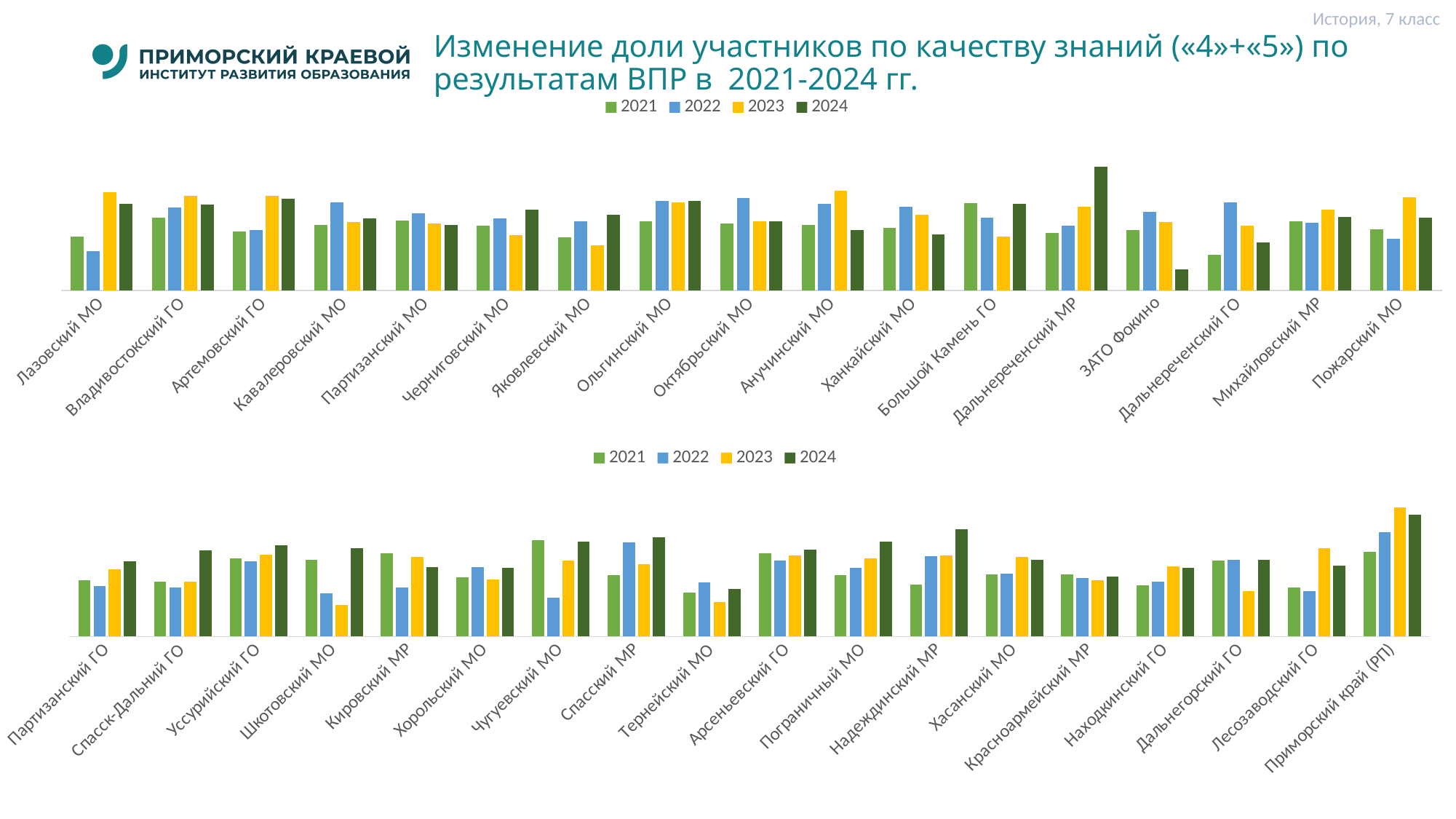
In the top chart, which year has the lowest bar for ЗАТО Фокино? 2024 In the top chart, which year has the highest bar for Дальнереченский МР? 2024 How many categories (municipalities) are shown on the x axis of the top chart? 17 How many categories are shown on the x axis of the bottom chart? 18 In the bottom chart, do the bars for Приморский край (РП) rise or fall from 2021 to 2023? rise In the top chart, for Дальнереченский ГО, is the 2022 bar or the 2023 bar taller? 2022 In the top chart, which year has the lowest bar for Лазовский МО? 2022 In the bottom chart, which year has the lowest bar for Шкотовский МО? 2023 What kind of chart is the top chart on the slide? bar chart What are the legend entries of the bottom chart? 2021, 2022, 2023, 2024 How many series does the legend of the top chart list? 4